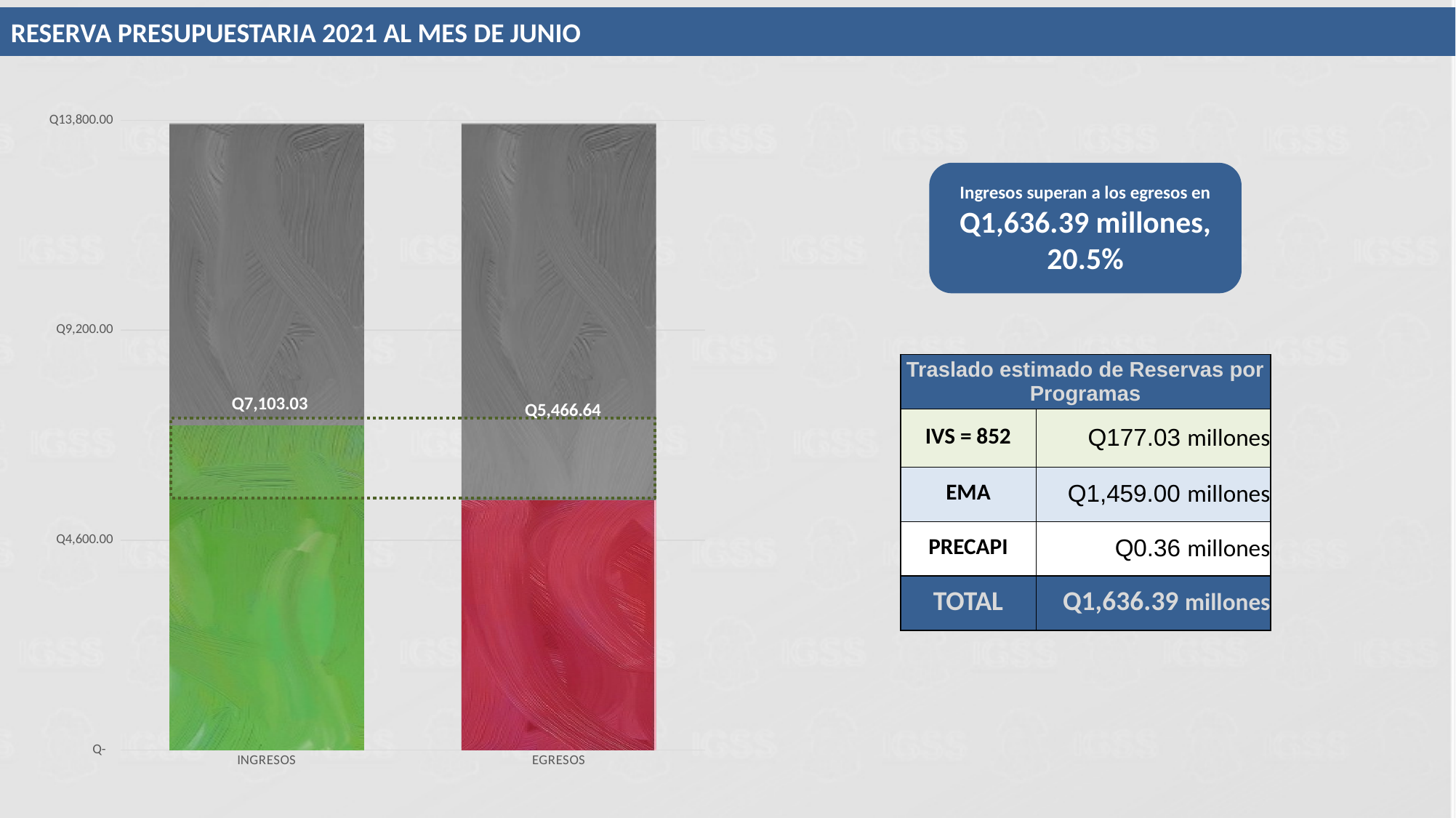
What is the highest tick value shown on the y axis? Q13,800.00 How many categories are shown on the x axis of the chart? 2 What is the value shown for EGRESOS? Q5,466.64 Which category has the lowest labelled value? EGRESOS Which category has the higher value, INGRESOS or EGRESOS? INGRESOS Is the value for INGRESOS greater or less than Q4,600.00? greater What is the value shown for INGRESOS? Q7,103.03 What kind of chart is shown on the slide? bar chart What colour is the lower portion of the EGRESOS bar? red Is the value for EGRESOS greater or less than Q9,200.00? less What is the difference between the INGRESOS value and the EGRESOS value? Q1,636.39